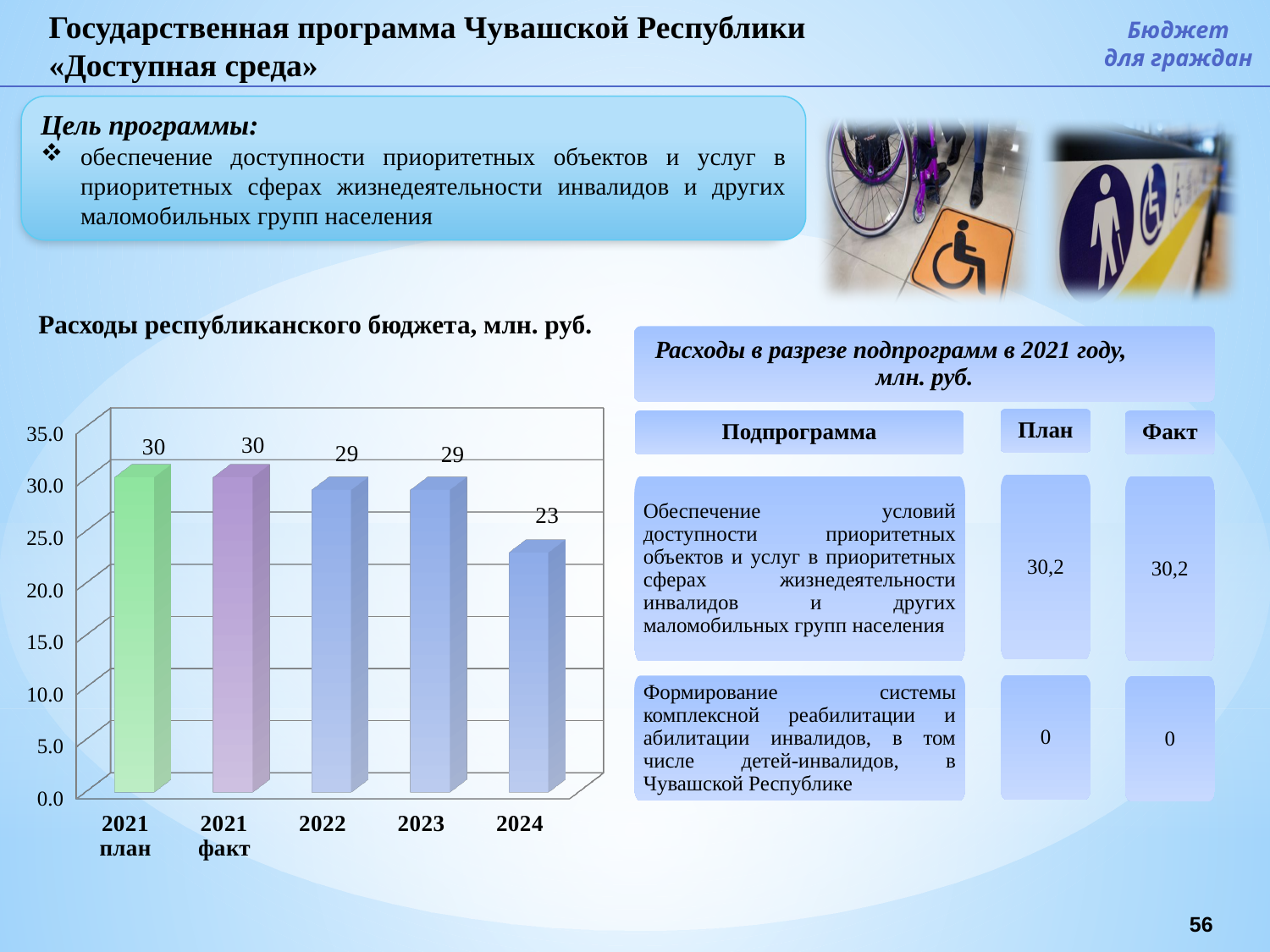
Which is larger in the chart 'Расходы республиканского бюджета, млн. руб.': the value for 2023 or the value for 2024? 2023 Is the value for 2024 in the chart 'Расходы республиканского бюджета, млн. руб.' greater or less than 25.0? less What is the value for 2022 in the chart 'Расходы республиканского бюджета, млн. руб.'? 29 What kind of chart is 'Расходы республиканского бюджета, млн. руб.'? bar chart What is the value for '2021 факт' in the chart 'Расходы республиканского бюджета, млн. руб.'? 30 Do the values in the chart 'Расходы республиканского бюджета, млн. руб.' rise or fall from '2021 факт' to 2024? fall What is the difference between the values for 2023 and 2024 in the chart 'Расходы республиканского бюджета, млн. руб.'? 6 What is the value for '2021 план' in the chart 'Расходы республиканского бюджета, млн. руб.'? 30 Which category has the lowest value in the chart 'Расходы республиканского бюджета, млн. руб.'? 2024 What is the difference between the values for '2021 план' and 2022 in the chart 'Расходы республиканского бюджета, млн. руб.'? 1 What is the value for 2024 in the chart 'Расходы республиканского бюджета, млн. руб.'? 23 How many categories are shown on the x axis of the chart 'Расходы республиканского бюджета, млн. руб.'? 5